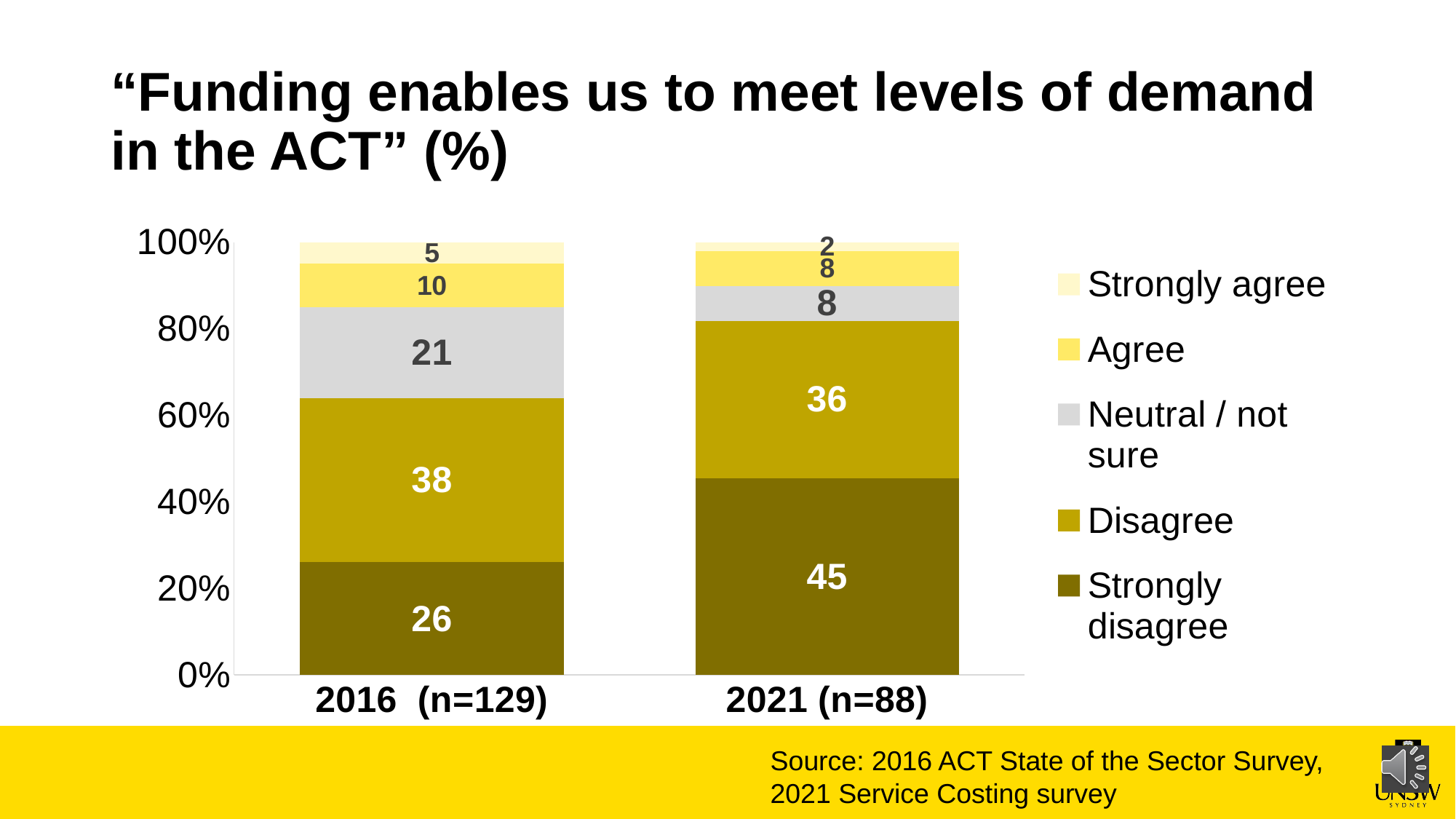
What is the value for Agree in 2016 (n=129)? 10 By how much did the Strongly disagree share change from 2016 to 2021? 19 What kind of chart is shown on the slide? Stacked bar chart How many series does the legend list? 5 Which response category has the largest share in 2016 (n=129)? Disagree What is the value for Strongly agree in 2021 (n=88)? 2 Which response category has the largest share in 2021 (n=88)? Strongly disagree What percentage of respondents strongly disagreed in 2021 (n=88)? 45 What is the value for Neutral / not sure in 2016 (n=129)? 21 What is the combined share of Agree and Strongly agree in 2016 (n=129)? 15 Which year has the larger Neutral / not sure share, 2016 or 2021? 2016 What percentage of respondents strongly disagreed in 2016 (n=129)? 26